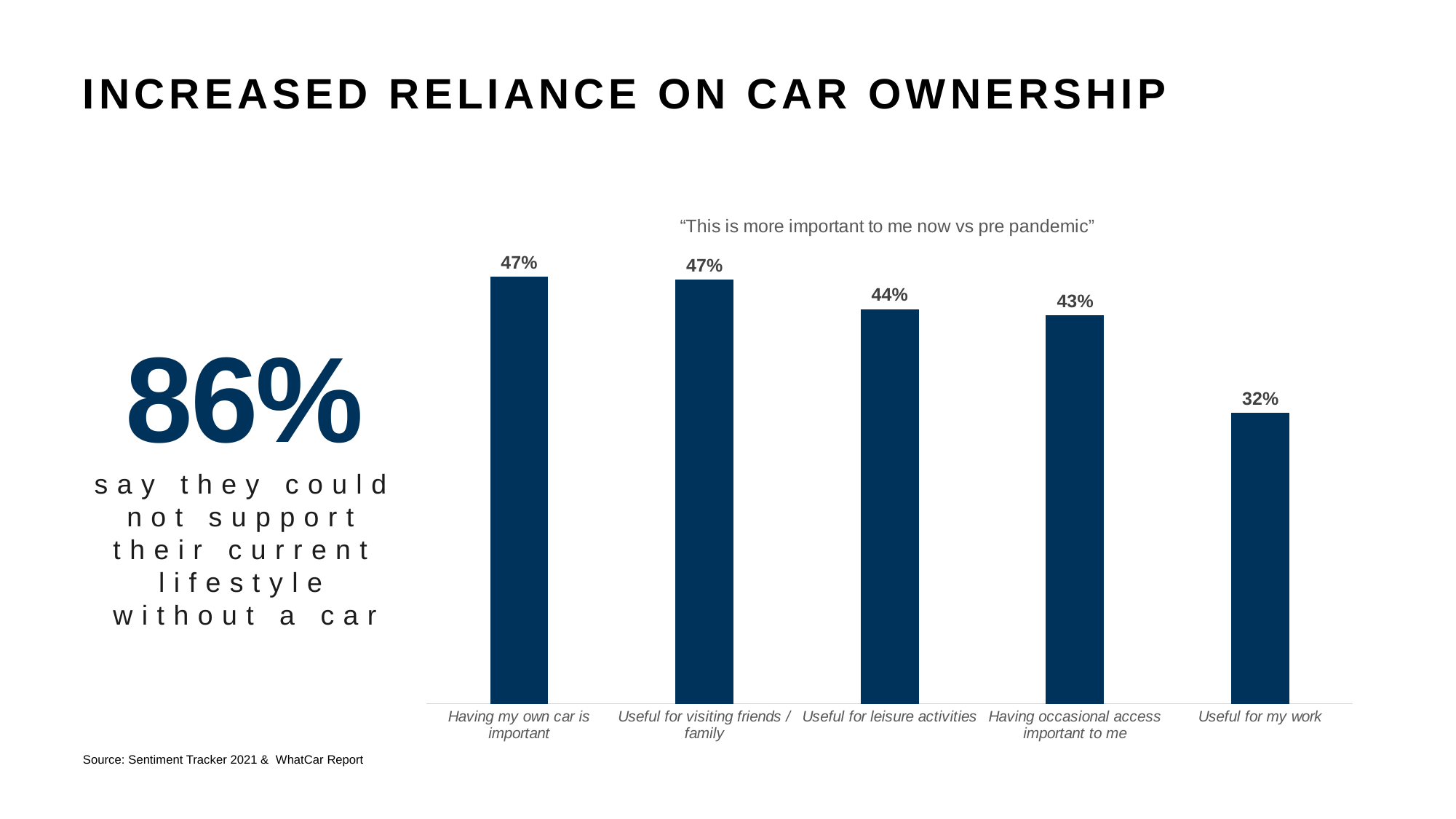
What is the value for "Having occasional access important to me"? 43% Which category has the lowest value? Useful for my work What is the difference between the values for "Having my own car is important" and "Useful for my work"? 15% What is the value for "Useful for my work"? 32% What is the difference between the values for "Useful for leisure activities" and "Having occasional access important to me"? 1% What is the value for "Having my own car is important"? 47% What kind of chart is shown on the slide? Bar chart Do the values rise or fall from left to right across the categories? Fall What is the title of the chart? "This is more important to me now vs pre pandemic" Which is larger, the value for "Useful for visiting friends / family" or the value for "Useful for my work"? Useful for visiting friends / family What is the value for "Useful for leisure activities"? 44% How many categories are shown in the chart? 5